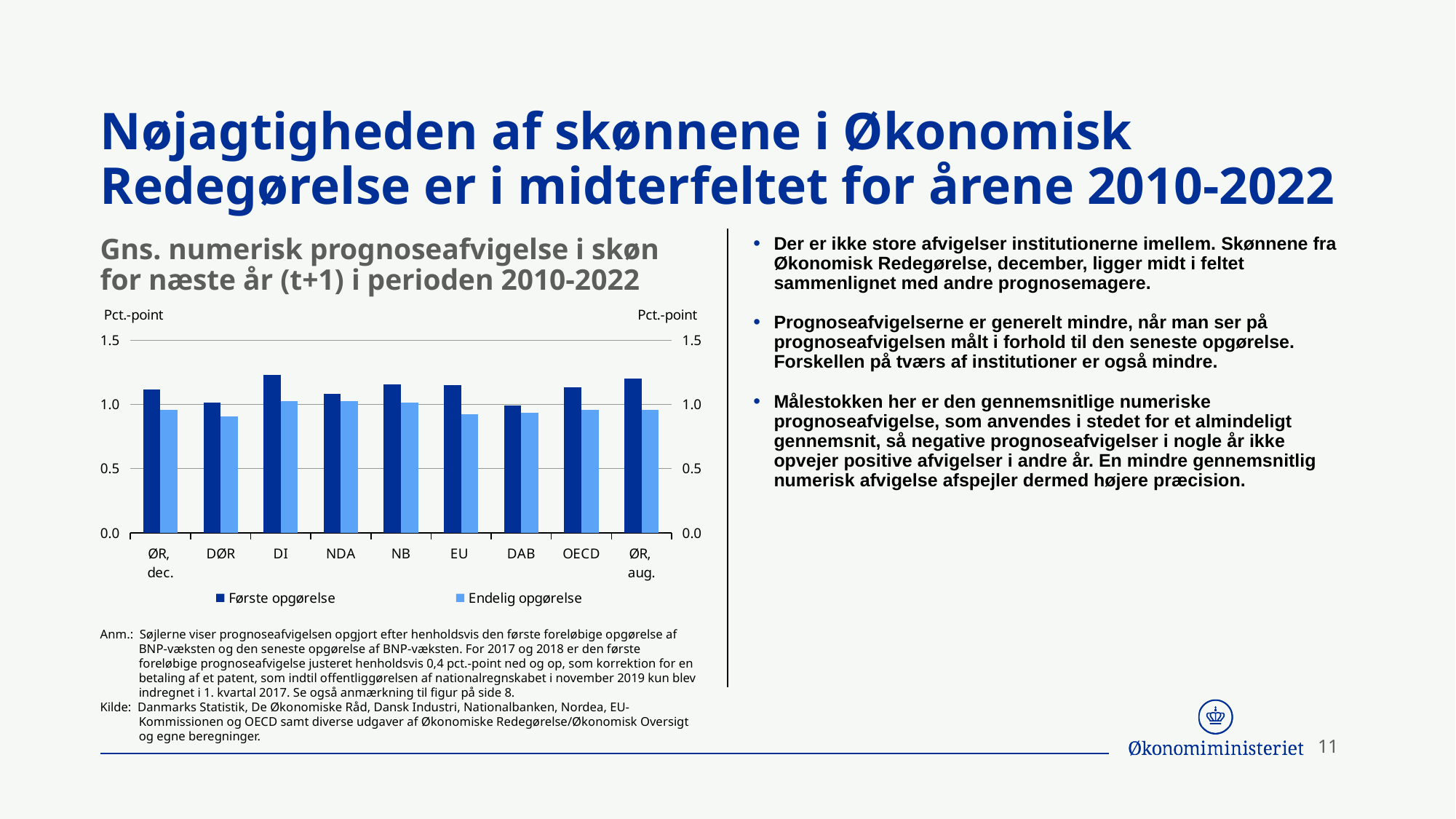
Is the Første opgørelse value for DI greater or less than 1.0? greater Which has the larger Første opgørelse value, DI or DØR? DI What kind of chart is shown on the slide? bar chart For DI, which is larger: the Første opgørelse value or the Endelig opgørelse value? Første opgørelse Is the Første opgørelse value for ØR, aug. greater or less than 1.0? greater How many institutions (categories) are shown on the x axis of the chart? 9 What unit is shown on the chart's y axis? Pct.-point How many series does the chart's legend list? 2 What are the two series named in the chart's legend? Første opgørelse and Endelig opgørelse Which has the larger Endelig opgørelse value, DØR or NDA? NDA Is the Endelig opgørelse value for DØR greater or less than 1.0? less